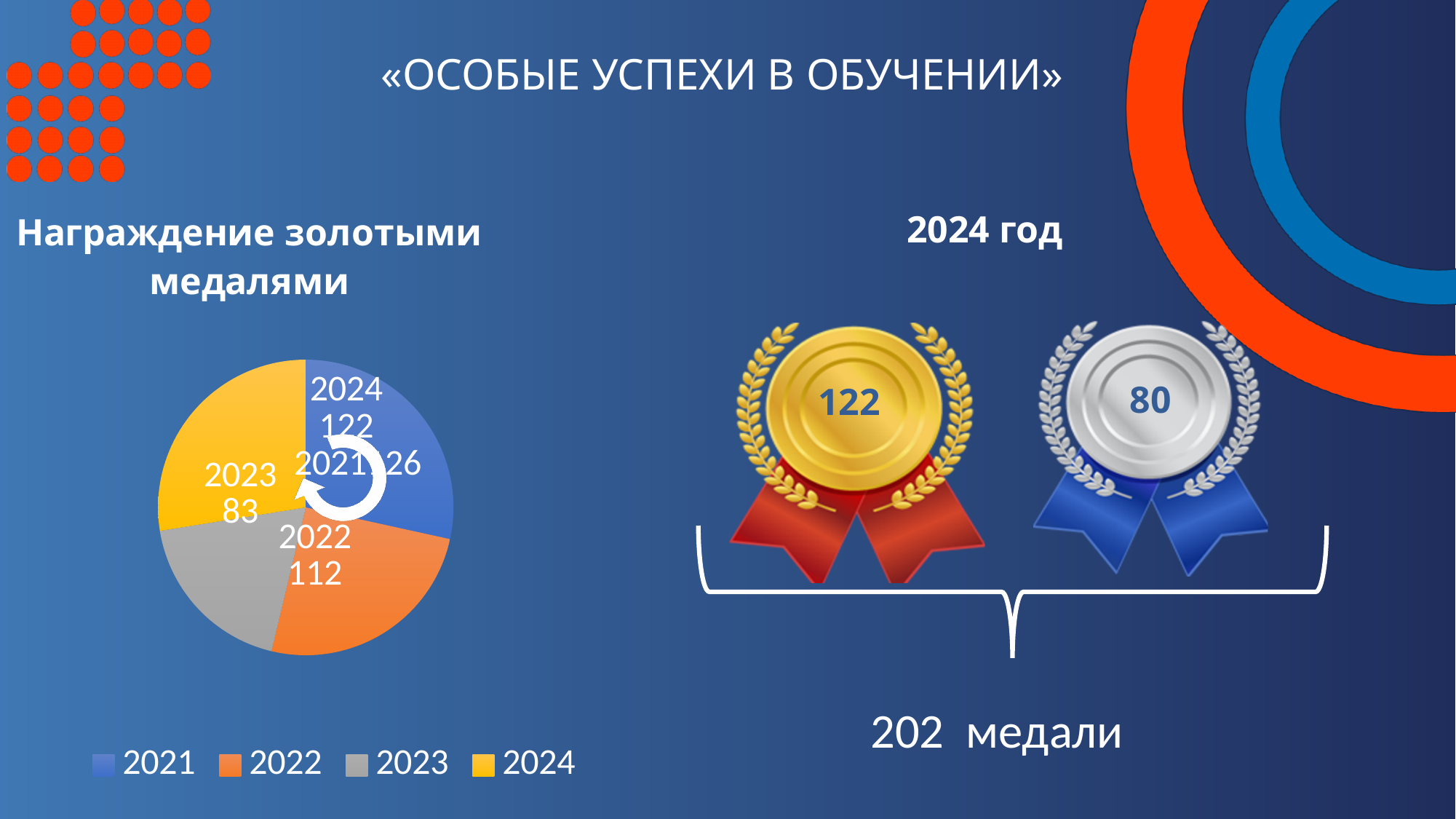
In the pie chart «Награждение золотыми медалями», what is the difference between the values for 2024 and 2022? 10 In the pie chart «Награждение золотыми медалями», what colour is the slice for 2024? yellow In the pie chart «Награждение золотыми медалями», what is the value for 2023? 83 In the pie chart «Награждение золотыми медалями», what is the value for 2022? 112 How many categories (years) does the pie chart «Награждение золотыми медалями» show? 4 In the pie chart «Награждение золотыми медалями», what is the difference between the values for 2022 and 2023? 29 What kind of chart is shown under the title «Награждение золотыми медалями»? pie chart How many entries does the legend of the pie chart «Награждение золотыми медалями» list? 4 In the pie chart «Награждение золотыми медалями», which year has the smallest slice? 2023 What is the title of the pie chart on the left of the slide? Награждение золотыми медалями In the pie chart «Награждение золотыми медалями», what is the value for 2024? 122 In the pie chart «Награждение золотыми медалями», which is larger, the value for 2022 or the value for 2023? 2022